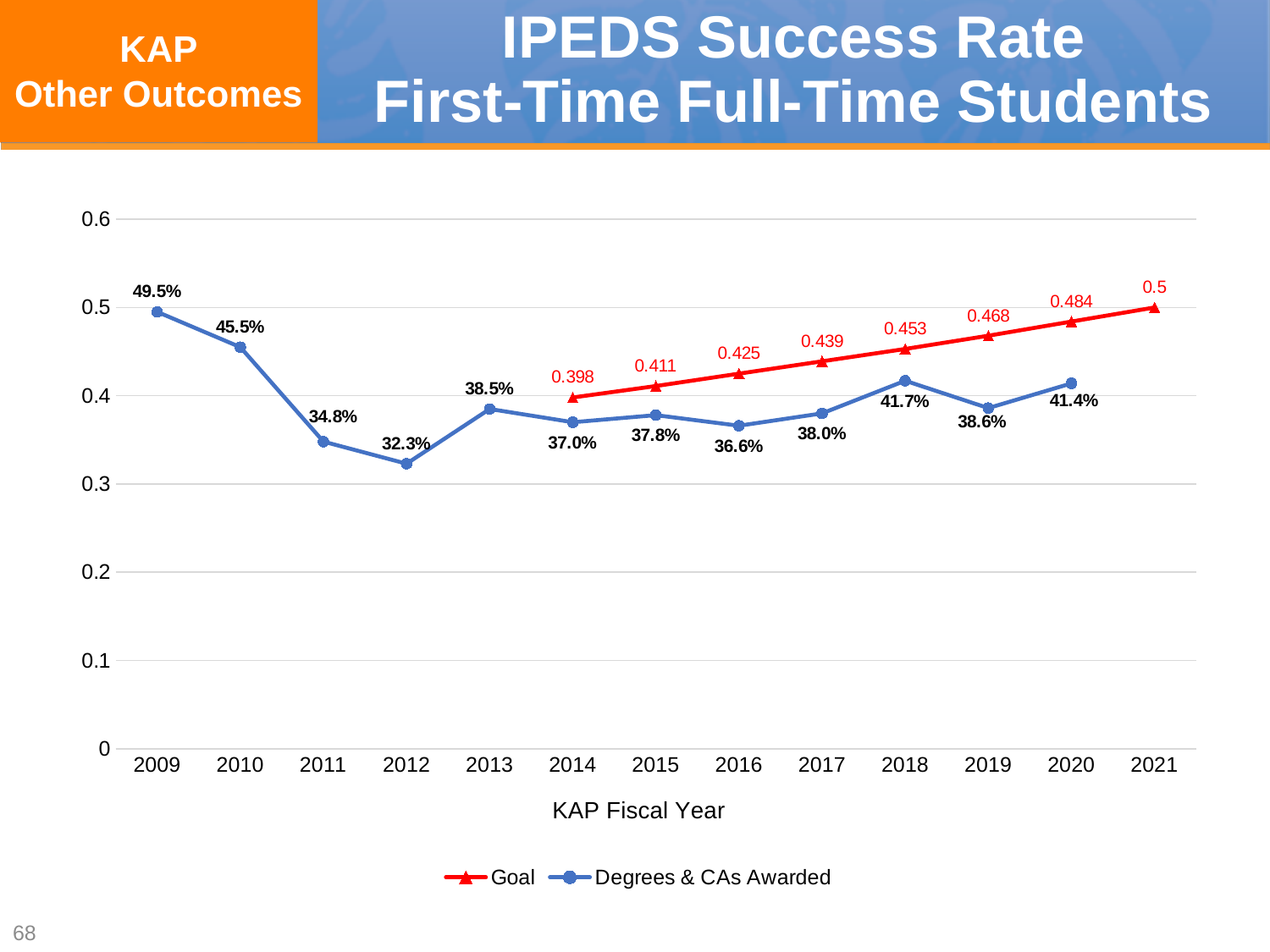
What is the Degrees & CAs Awarded value for 2009? 49.5% What is the Goal value for 2021? 0.5 How many series does the legend list? 2 Which is larger in 2016, the Goal value or the Degrees & CAs Awarded value? Goal What kind of chart is shown on the slide? line chart What is the Degrees & CAs Awarded value for 2018? 41.7% What is the x-axis title of the chart? KAP Fiscal Year In which year is the Degrees & CAs Awarded value lowest? 2012 In which year is the Degrees & CAs Awarded value highest? 2009 What is the Goal value for 2017? 0.439 What is the difference between the Degrees & CAs Awarded values for 2009 and 2010? 4.0% How many years are shown on the x axis? 13